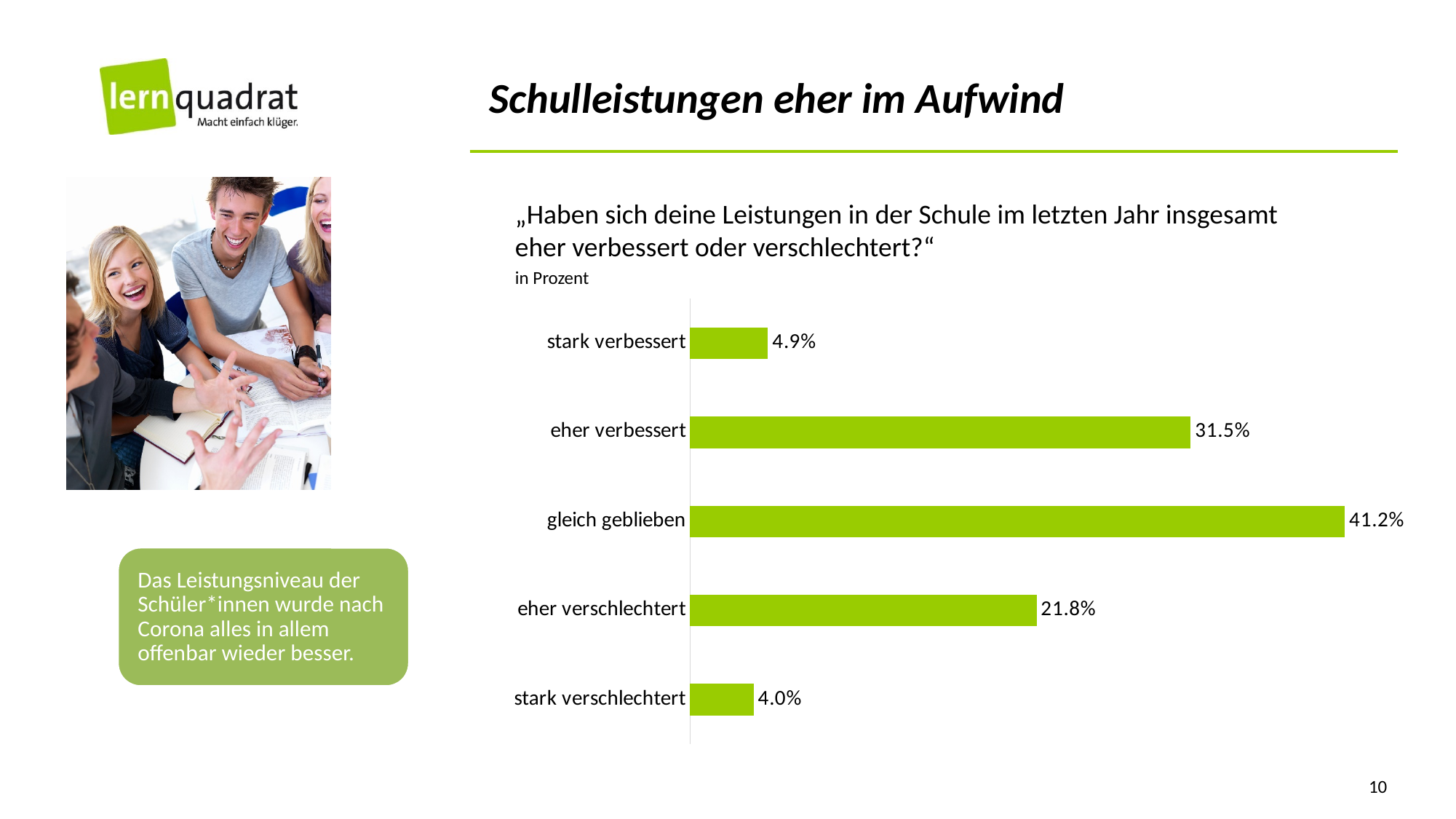
Which category has the lowest value? stark verschlechtert What kind of chart is shown on the slide? bar chart What is the value for "gleich geblieben"? 41.2% Which category has the highest value? gleich geblieben What is the value for "eher verschlechtert"? 21.8% Which is larger, "stark verbessert" or "stark verschlechtert"? stark verbessert What is the value for "eher verbessert"? 31.5% What is the difference between "eher verbessert" and "eher verschlechtert"? 9.7% What is the value for "stark verschlechtert"? 4.0% How many categories are shown in the chart? 5 What unit are the chart values given in, according to the label under the question? in Prozent What is the difference between "gleich geblieben" and "eher verbessert"? 9.7%